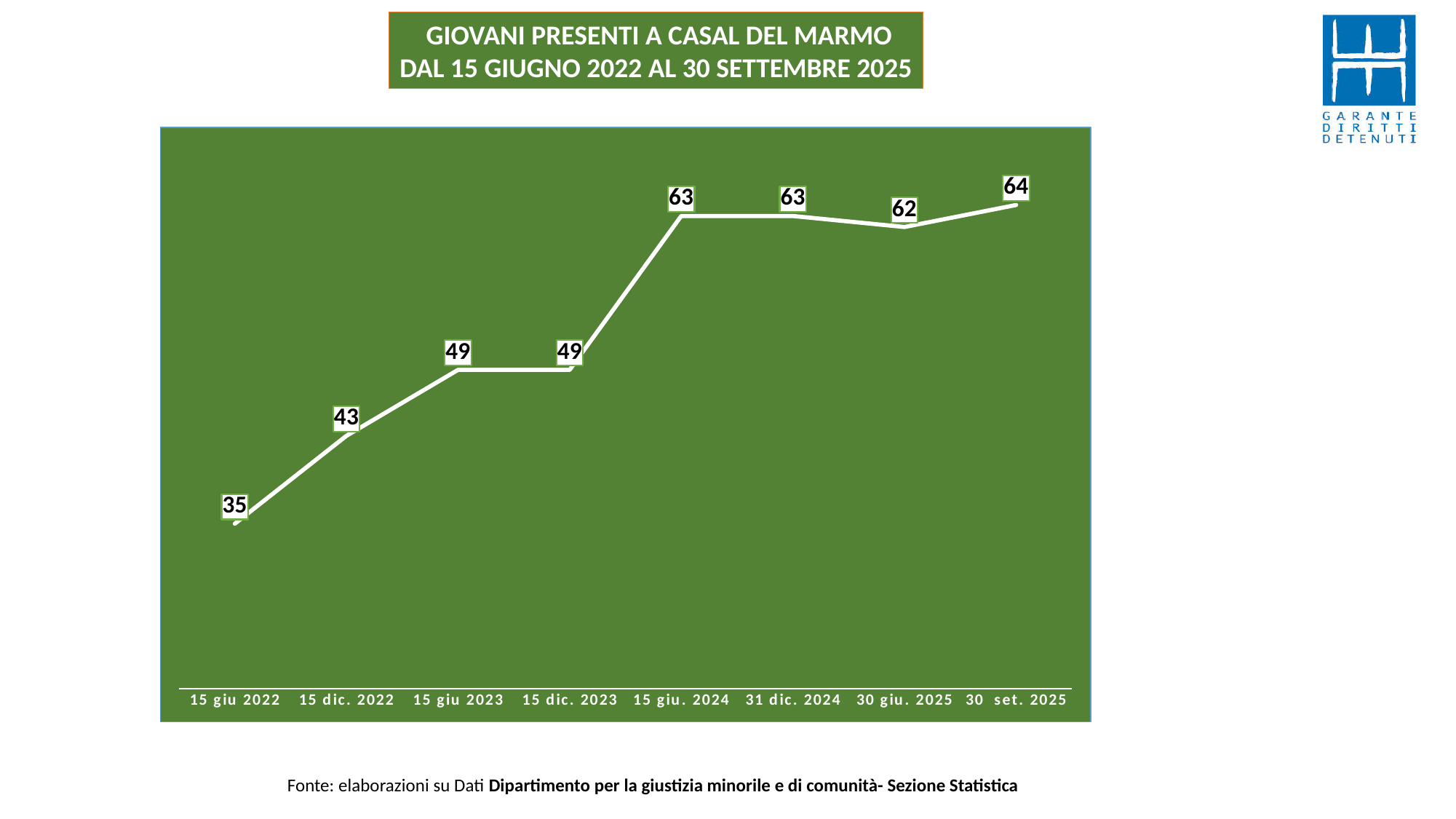
Which is larger, the value for 31 dic. 2024 or the value for 30 giu. 2025? 31 dic. 2024 What is the value for 15 giu 2022? 35 Do the values generally rise or fall from 15 giu 2022 to 30 set. 2025? rise What is the title of the chart? GIOVANI PRESENTI A CASAL DEL MARMO DAL 15 GIUGNO 2022 AL 30 SETTEMBRE 2025 What is the difference between the values for 30 set. 2025 and 15 giu 2022? 29 What is the value for 15 dic. 2023? 49 What is the value for 30 set. 2025? 64 What is the difference between the values for 15 giu. 2024 and 15 dic. 2023? 14 Which date has the lowest value? 15 giu 2022 Which date has the highest value? 30 set. 2025 How many dates are plotted on the x axis? 8 What kind of chart is shown on the slide? line chart